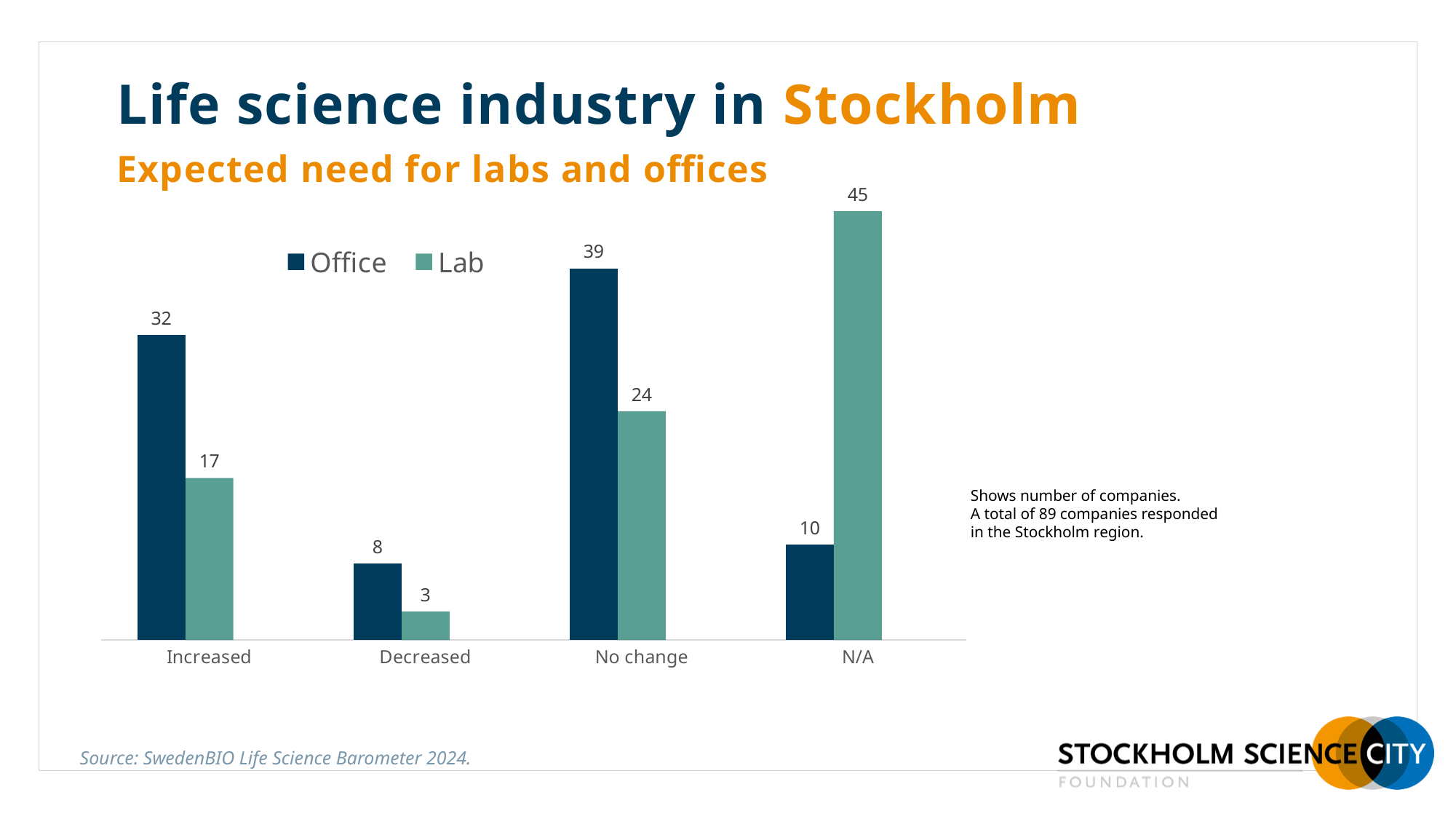
Which category has the highest Office value? No change How many series does the legend list? 2 What is the Office value for the Increased category? 32 What is the difference between the Office and Lab values for the No change category? 15 What kind of chart is shown on the slide? Bar chart What is the subtitle of the chart? Expected need for labs and offices Which category has the lowest Lab value? Decreased What is the Lab value for the Decreased category? 3 Which is larger for the N/A category, Office or Lab? Lab How many categories are shown on the x axis? 4 What is the difference between the Office values for Increased and Decreased? 24 What is the Lab value for the N/A category? 45